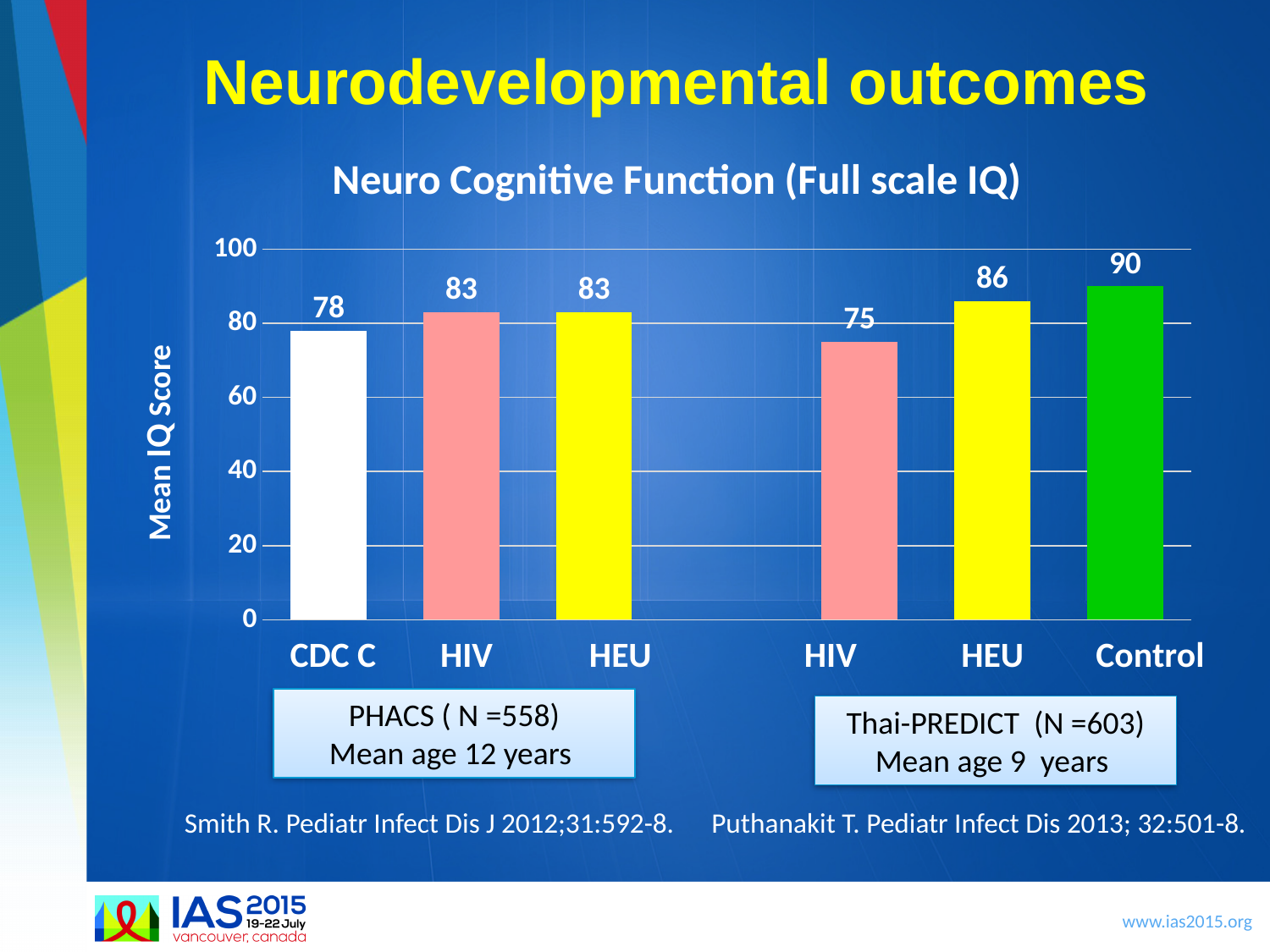
Which group has the highest mean IQ score on the chart? Control What is the difference in mean IQ score between the Control group and the HIV group in the Thai-PREDICT study? 15 What is the mean IQ score for the HIV group in the Thai-PREDICT study? 75 Which group has the lowest mean IQ score on the chart? HIV (Thai-PREDICT) What is the label of the y-axis on the chart? Mean IQ Score Which has a higher mean IQ score: the HEU group in the Thai-PREDICT study or the HEU group in the PHACS study? HEU in Thai-PREDICT What is the mean IQ score for the Control group in the Thai-PREDICT study? 90 How many bars are plotted on the chart? 6 What is the mean IQ score for the HEU group in the PHACS study? 83 What is the difference in mean IQ score between the HEU group and the CDC C group in the PHACS study? 5 What type of chart is shown on the slide? Bar chart What is the mean IQ score for the CDC C group in the PHACS study? 78